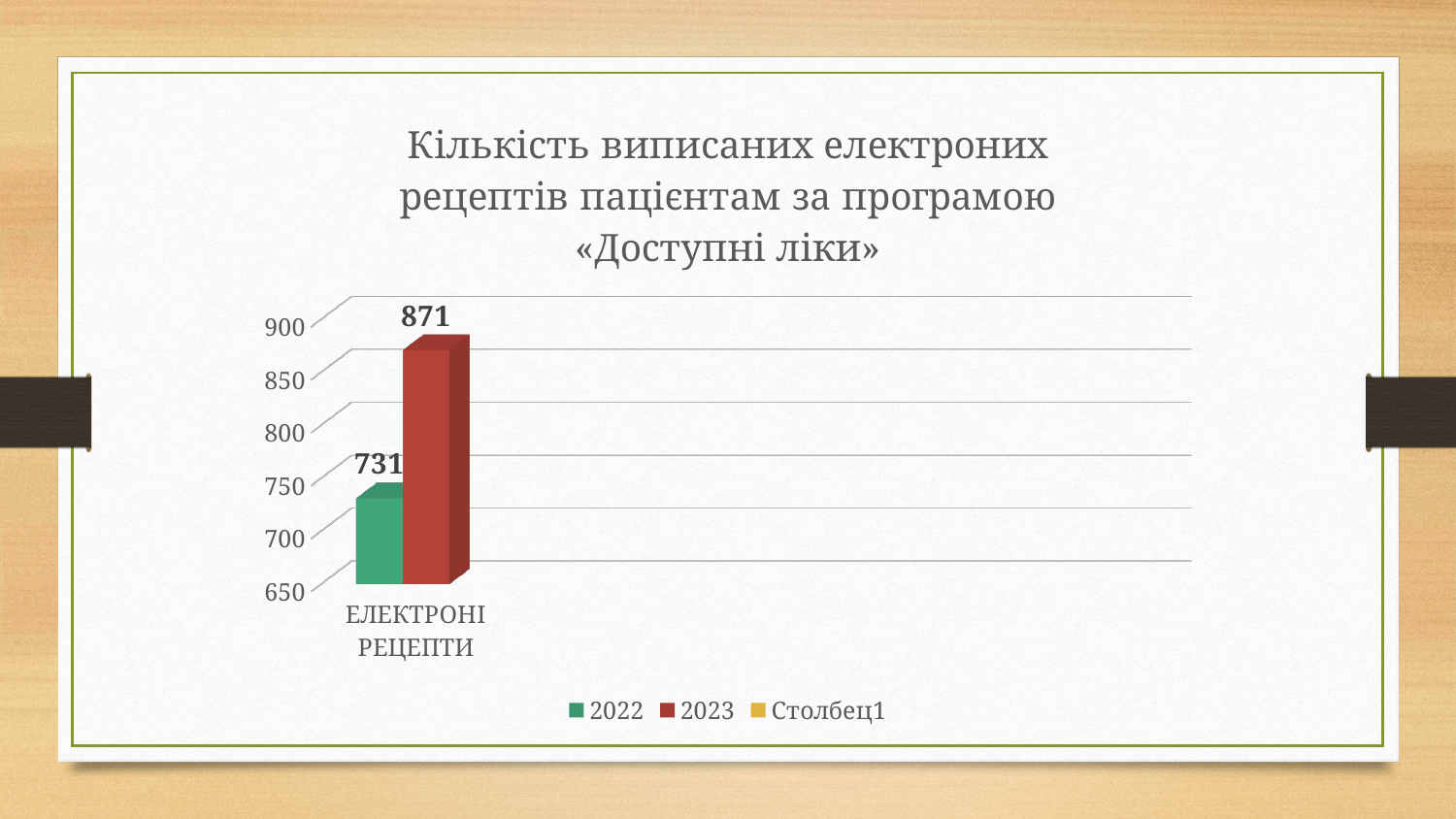
How many categories are shown on the x axis? 1 Which series has the higher value, 2022 or 2023? 2023 What is the value for 2023 in the chart? 871 Which series has the lowest plotted value? 2022 What is the value for 2022 in the chart? 731 What kind of chart is shown on the slide? bar chart Is the value for 2023 greater or less than 850? greater How many series does the legend list? 3 What is the difference between the 2023 value and the 2022 value? 140 What colour is the bar for 2023? red What is the category label on the x axis? ЕЛЕКТРОНІ РЕЦЕПТИ Is the value for 2022 greater or less than 750? less